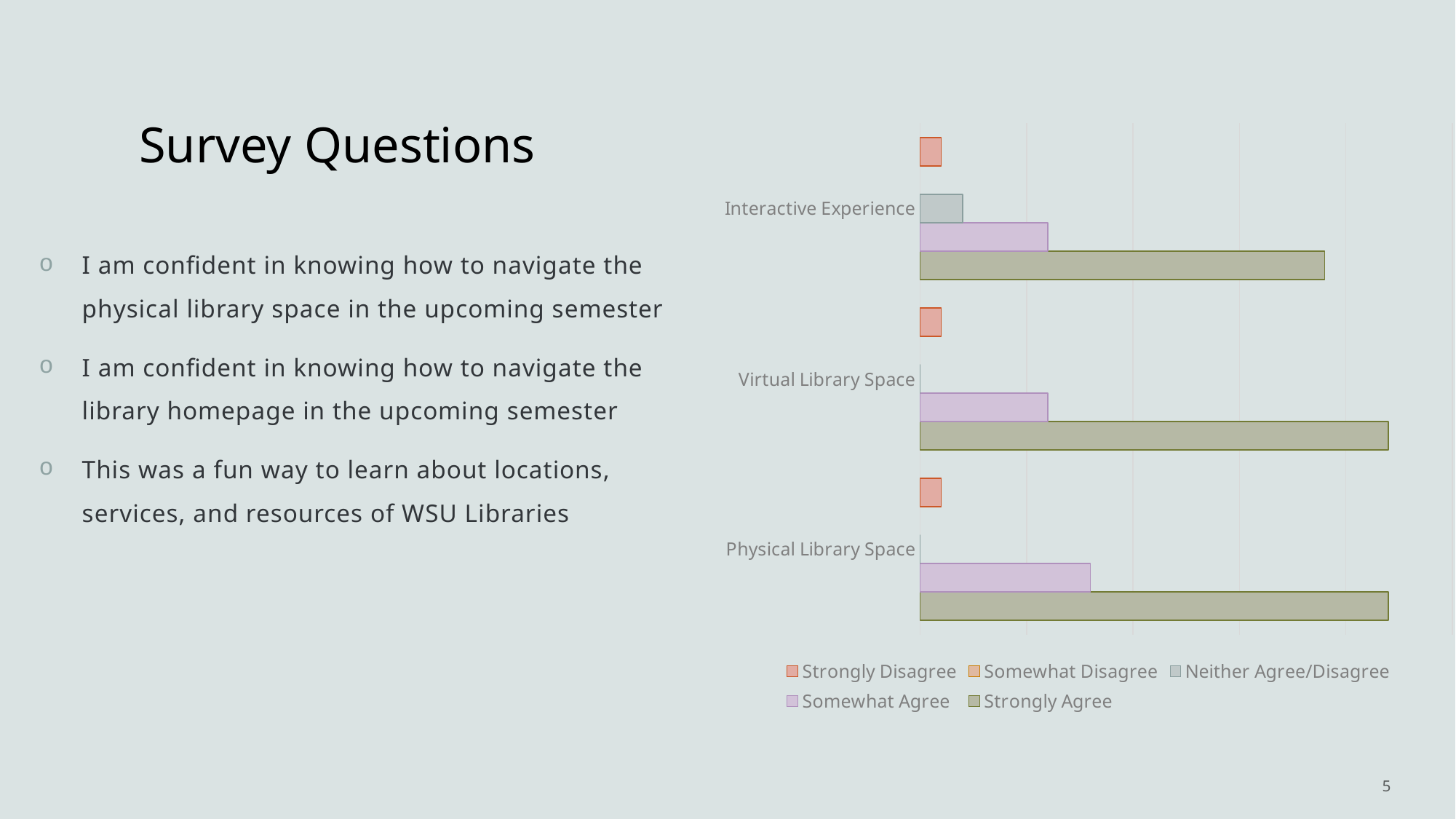
Is the Somewhat Agree bar longer for Physical Library Space or for Virtual Library Space? Physical Library Space For Physical Library Space, which response has the longest bar? Strongly Agree How many series does the chart legend list? 5 What kind of chart is shown on the slide? bar chart How many categories are plotted on the chart? 3 For Virtual Library Space, which is larger: Strongly Agree or Somewhat Agree? Strongly Agree Is the Strongly Agree bar longer for Interactive Experience or for Virtual Library Space? Virtual Library Space Which category is listed at the top of the chart? Interactive Experience Which category shows a visible Neither Agree/Disagree bar? Interactive Experience For Interactive Experience, which response has the longest bar? Strongly Agree Which category has the shortest Strongly Agree bar? Interactive Experience